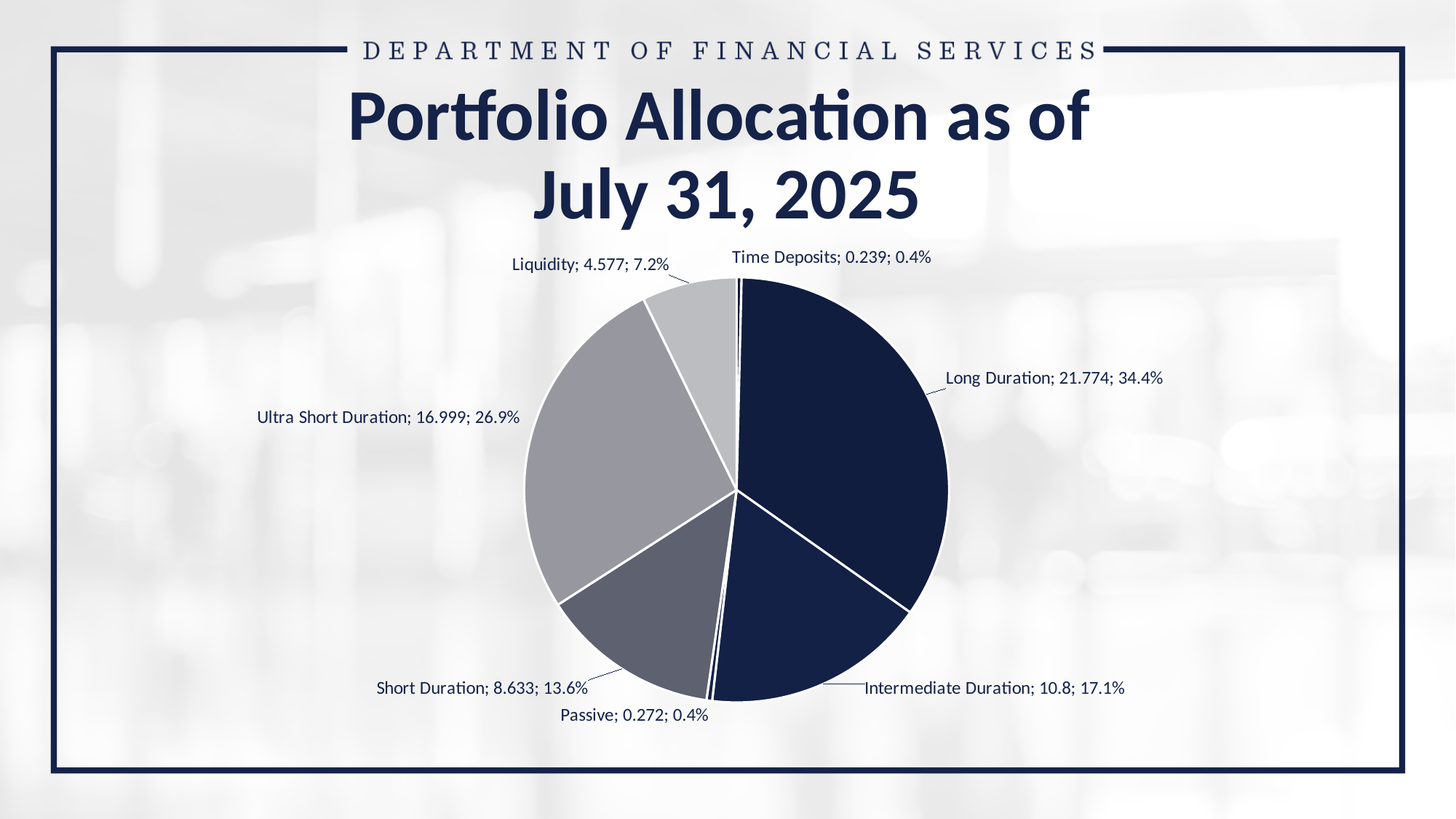
Which is larger, Short Duration or Intermediate Duration? Intermediate Duration What value is shown for Long Duration? 21.774 What percentage share does Liquidity have? 7.2% What percentage share does Ultra Short Duration have? 26.9% How many categories are shown in the pie chart? 7 What is the difference in percentage share between Intermediate Duration and Short Duration? 3.5% What value is shown for Intermediate Duration? 10.8 Which category has the smallest value? Time Deposits What is the title of the chart on the slide? Portfolio Allocation as of July 31, 2025 What kind of chart is shown on the slide? Pie chart Which category has the largest share of the pie? Long Duration What is the difference in value between Long Duration and Ultra Short Duration? 4.775